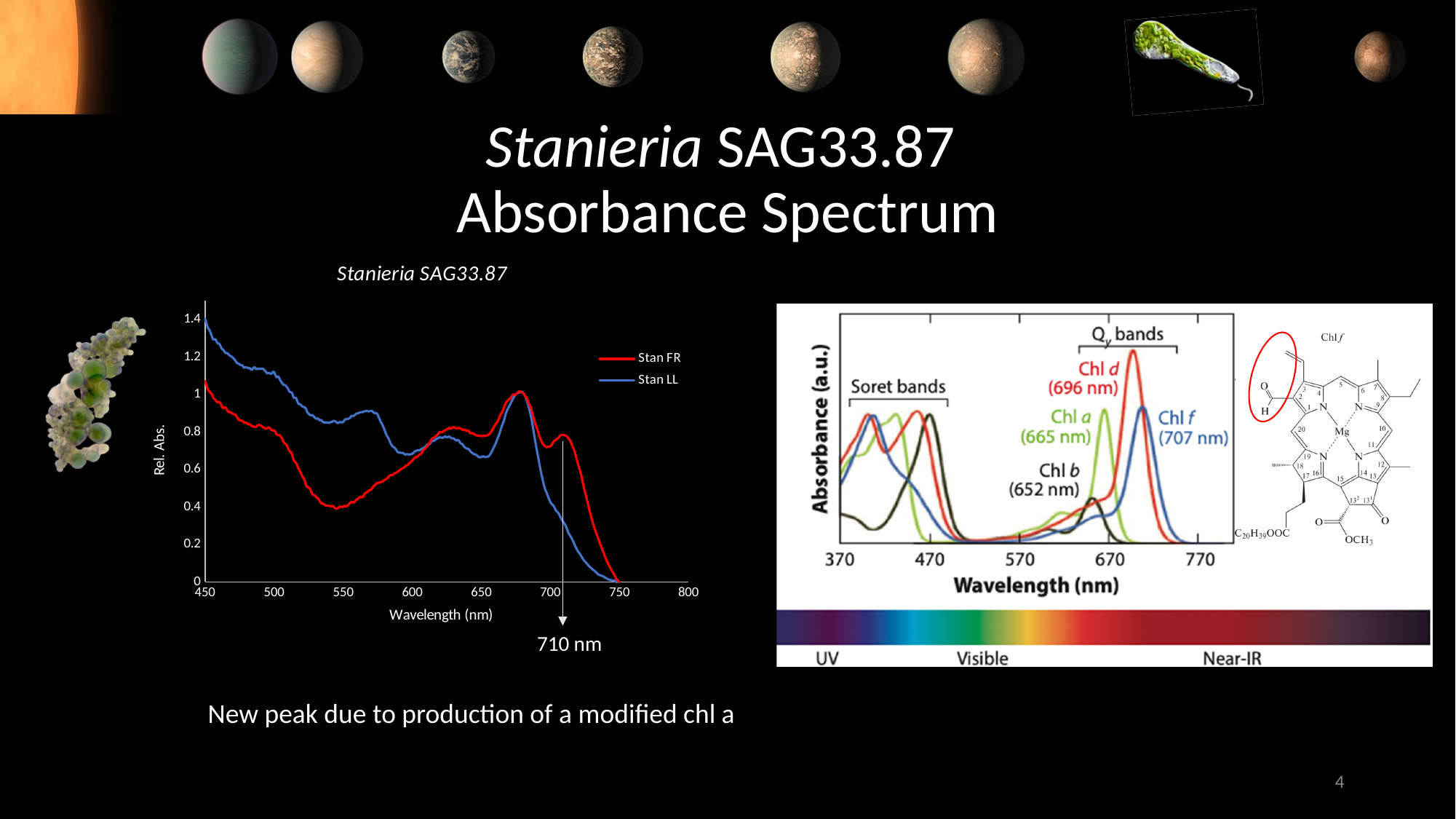
In the absorbance chart on the right of the slide, which chlorophyll has the Qy band at the longest wavelength? Chl f In the absorbance chart on the right of the slide, at what wavelength is the Chl f Qy band labelled? 707 nm In the Stanieria SAG33.87 chart, is the Stan FR value at 710 nm greater or less than 0.6? greater In the absorbance chart on the right of the slide, at what wavelength is the Chl d Qy band labelled? 696 nm In the Stanieria SAG33.87 chart, what wavelength is marked by the arrow annotation below the x axis? 710 nm In the Stanieria SAG33.87 chart, is the Stan FR value at 550 nm greater or less than 0.6? less In the Stanieria SAG33.87 chart, is the Stan LL value at 450 nm greater or less than 1.2? greater How many series does the legend of the Stanieria SAG33.87 chart list? 2 In the Stanieria SAG33.87 chart, which series has the higher relative absorbance at 450 nm, Stan FR or Stan LL? Stan LL What kind of chart is the Stanieria SAG33.87 chart on the left of the slide? line chart What are the two series named in the legend of the Stanieria SAG33.87 chart? Stan FR and Stan LL In the Stanieria SAG33.87 chart, does the Stan LL curve rise or fall between 450 nm and 550 nm? fall